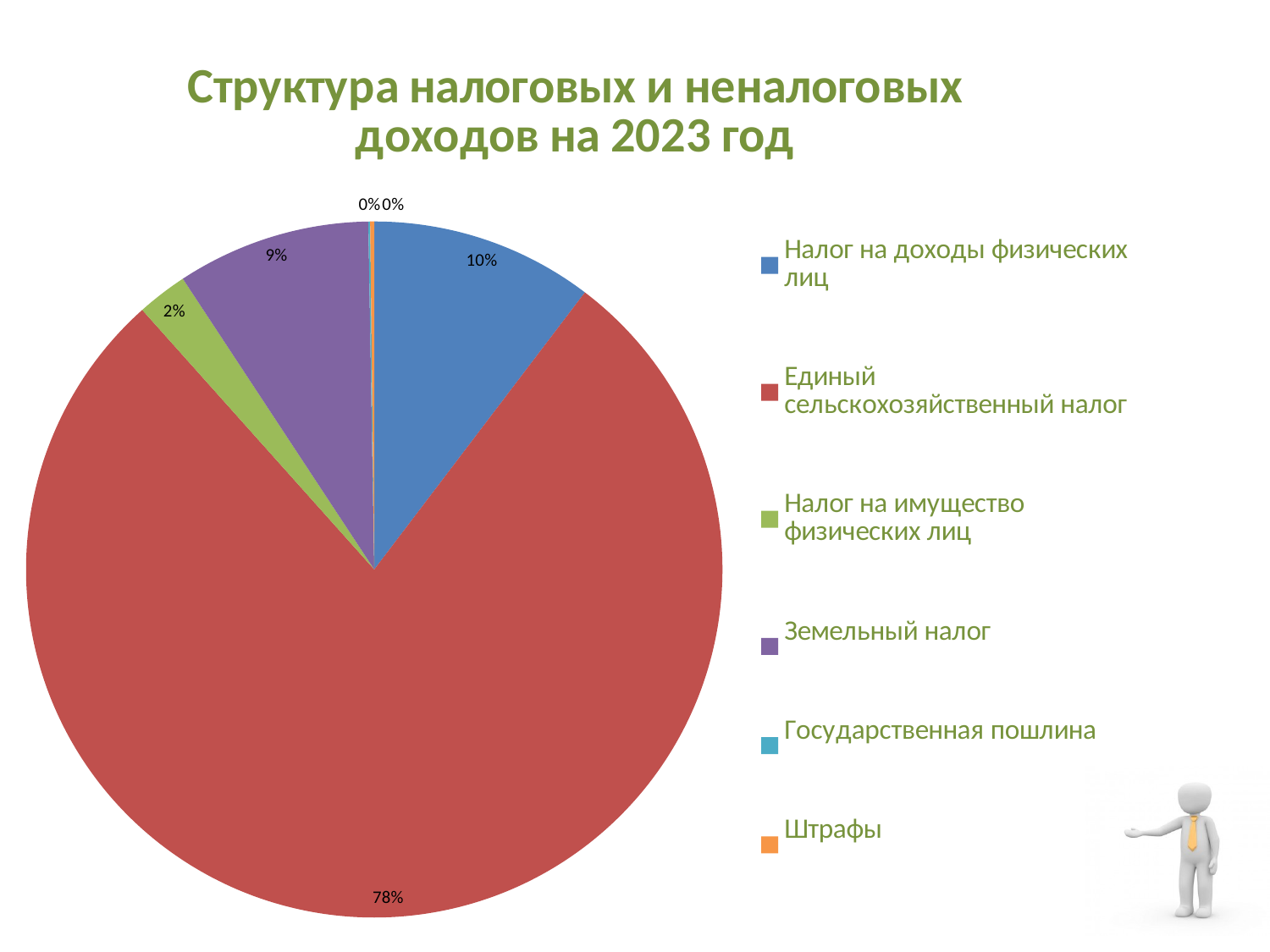
What share of the pie does Налог на имущество физических лиц have? 2% Which is larger: the share of Земельный налог or the share of Налог на имущество физических лиц? Земельный налог What share of the pie does Единый сельскохозяйственный налог have? 78% What kind of chart is shown on the slide? pie chart What share of the pie does Штрафы have? 0% Which category has the largest share of the pie? Единый сельскохозяйственный налог What is the difference between the shares of Налог на доходы физических лиц and Земельный налог? 1% How many categories does the legend list? 6 What colour is the slice for Единый сельскохозяйственный налог? red What is the title of the chart? Структура налоговых и неналоговых доходов на 2023 год